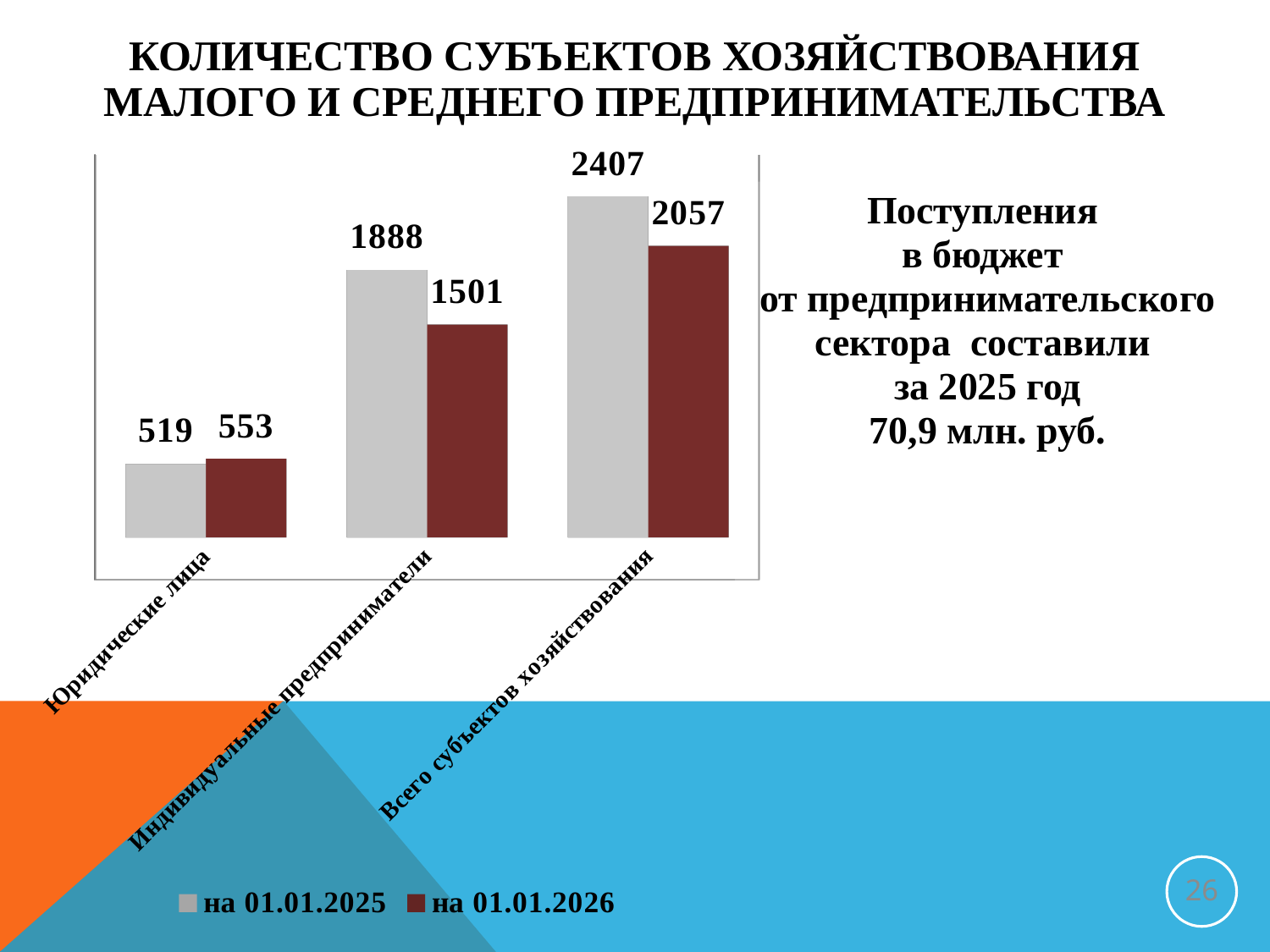
For Юридические лица, which series has the larger value: на 01.01.2025 or на 01.01.2026? на 01.01.2026 What is the value for Всего субъектов хозяйствования in the series на 01.01.2025? 2407 How many categories are shown on the x axis of the chart? 3 What kind of chart is shown on the slide? bar chart Which category has the highest value in the series на 01.01.2025? Всего субъектов хозяйствования What is the difference between the values for Индивидуальные предприниматели in the series на 01.01.2025 and на 01.01.2026? 387 What is the value for Индивидуальные предприниматели in the series на 01.01.2026? 1501 What is the difference between the values for Всего субъектов хозяйствования in the series на 01.01.2025 and на 01.01.2026? 350 How many series does the legend list? 2 What is the value for Юридические лица in the series на 01.01.2026? 553 Which category has the lowest value in the series на 01.01.2026? Юридические лица What is the value for Юридические лица in the series на 01.01.2025? 519